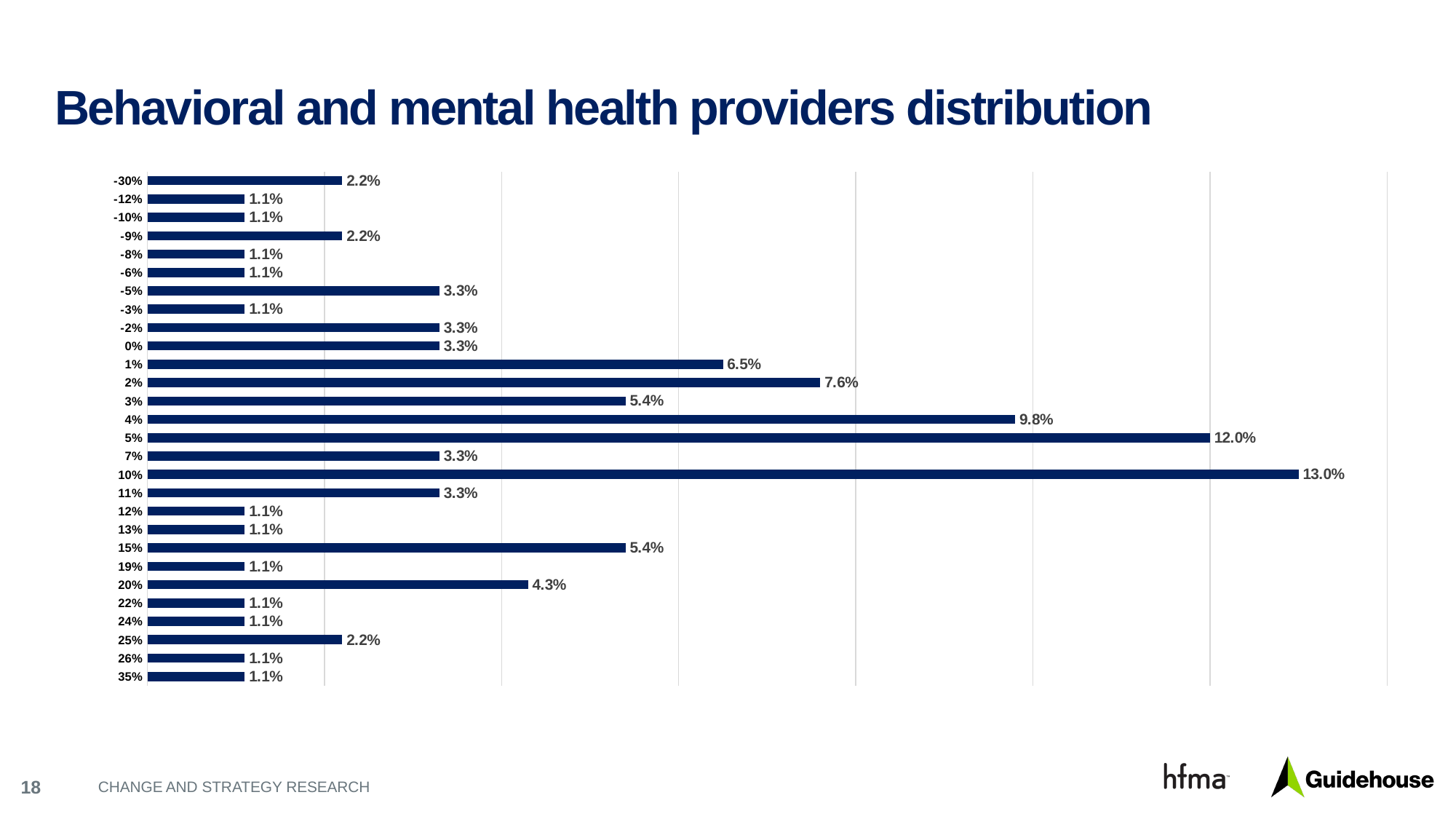
What is the value for the 10% category? 13.0% What is the value for the 20% category? 4.3% What is the value for the 5% category? 12.0% Which has a larger value, the 4% category or the 2% category? 4% How many categories are shown in the chart? 28 What is the difference between the values for the 10% and 5% categories? 1.0% Which category has the highest value? 10% What is the value for the -30% category? 2.2% What is the value for the 15% category? 5.4% What is the difference between the values for the 4% and 2% categories? 2.2% Which has a larger value, the 1% category or the 3% category? 1% What kind of chart is shown on the slide? Bar chart